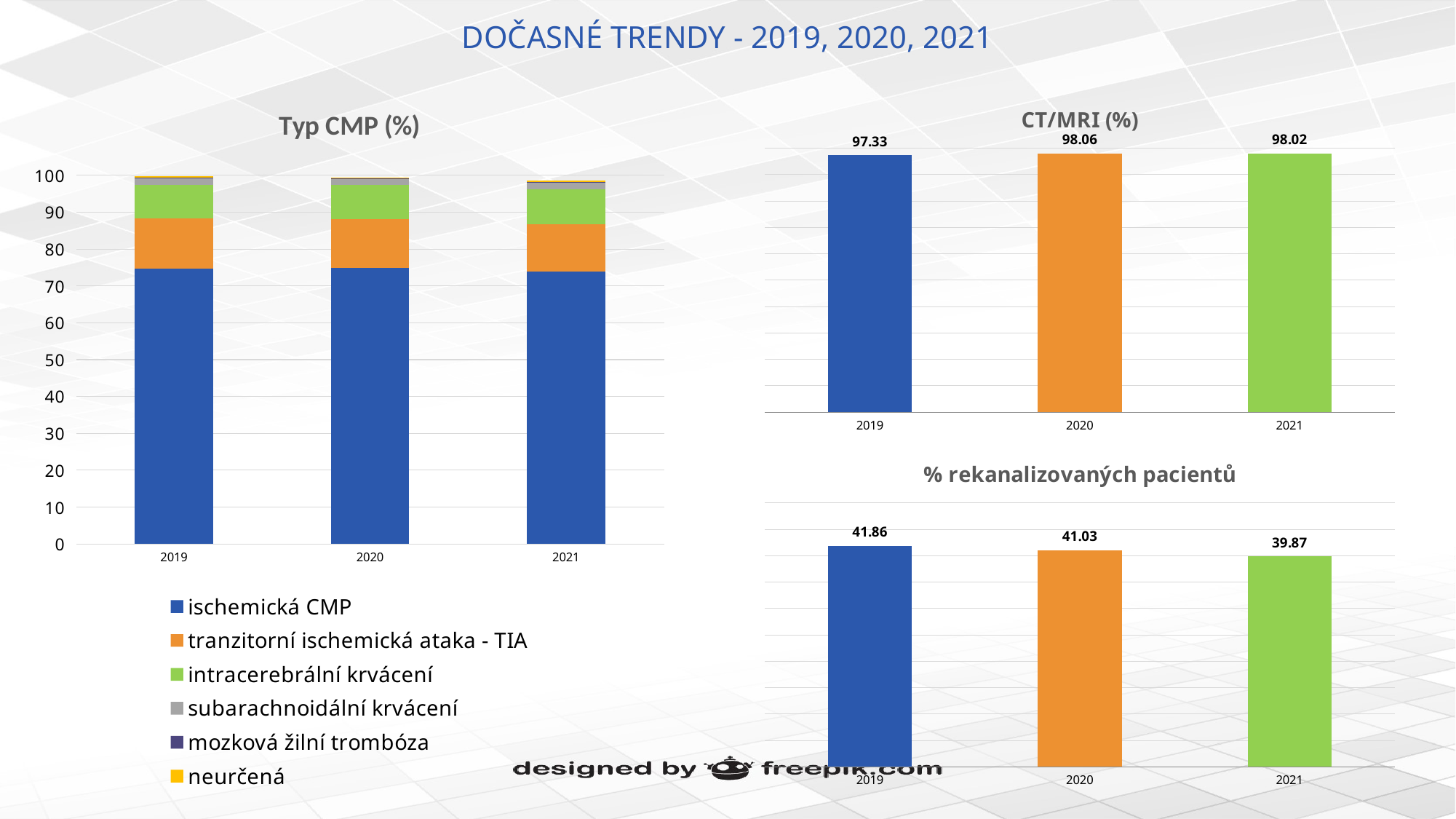
In the % rekanalizovaných pacientů chart, which year has the highest value? 2019 How many series does the legend of the Typ CMP (%) chart list? 6 In the CT/MRI (%) chart, what is the value for 2020? 98.06 In the % rekanalizovaných pacientů chart, what is the difference between the 2019 and 2021 values? 1.99 In the % rekanalizovaných pacientů chart, what is the value for 2021? 39.87 In the % rekanalizovaných pacientů chart, what is the value for 2019? 41.86 In the Typ CMP (%) chart, is the ischemická CMP value for 2019 greater or less than 70? greater In the % rekanalizovaných pacientů chart, do the values rise or fall from 2019 to 2021? fall What kind of chart is the Typ CMP (%) chart? stacked bar chart In the CT/MRI (%) chart, what is the difference between the 2020 and 2019 values? 0.73 In the CT/MRI (%) chart, which year has the lowest value? 2019 In the CT/MRI (%) chart, what is the value for 2019? 97.33